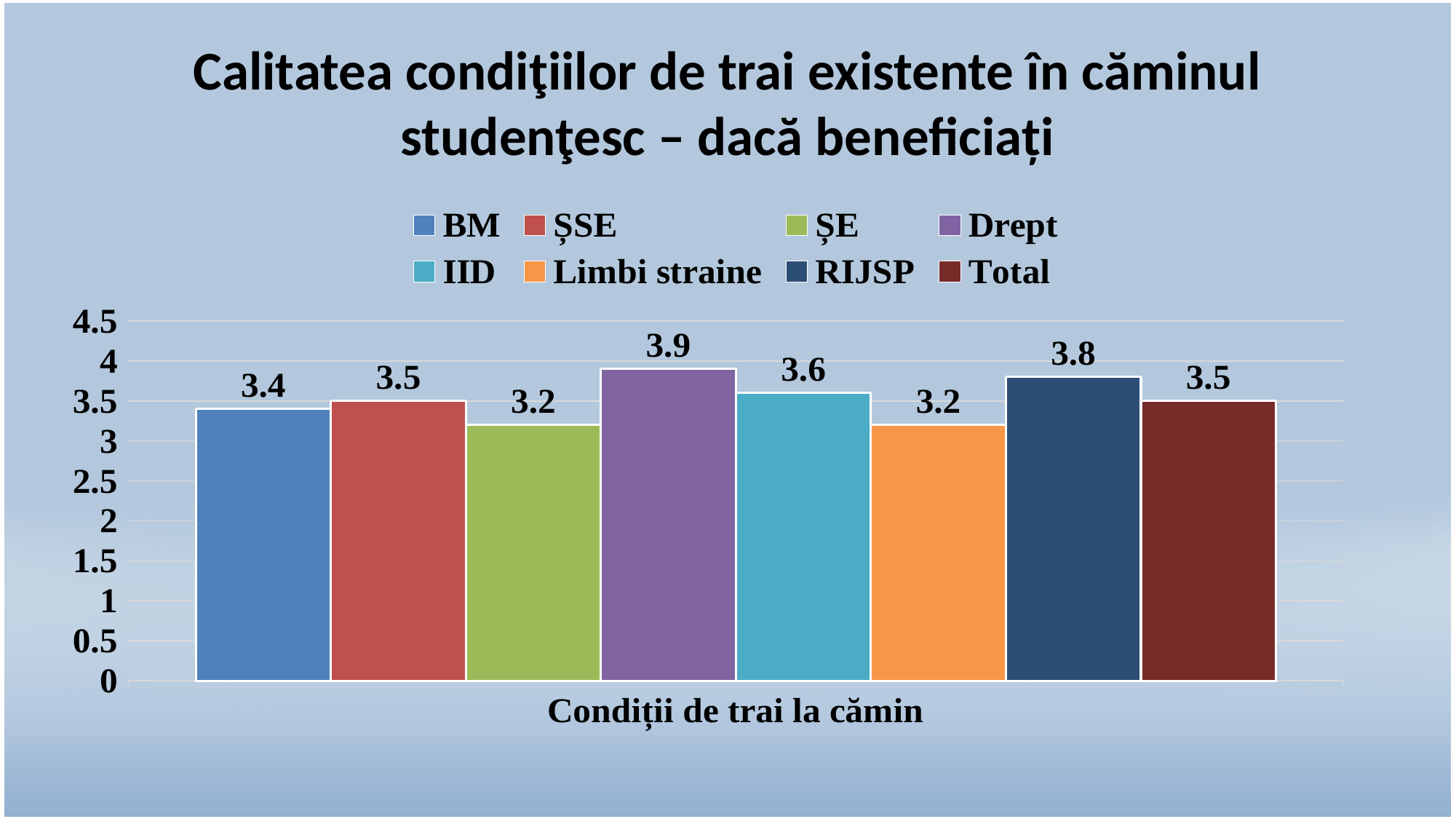
Which is larger, the value for IID or the value for ȘSE? IID What is the value for Total? 3.5 What is the difference between the values for RIJSP and ȘE? 0.6 What is the difference between the values for Drept and BM? 0.5 What is the x-axis label of the chart? Condiții de trai la cămin Is the value for Drept greater or less than 3.5? greater What is the value for RIJSP? 3.8 What kind of chart is shown? bar chart What is the value for Limbi straine? 3.2 How many series does the legend list? 8 What is the value for Drept? 3.9 Which series has the highest value? Drept